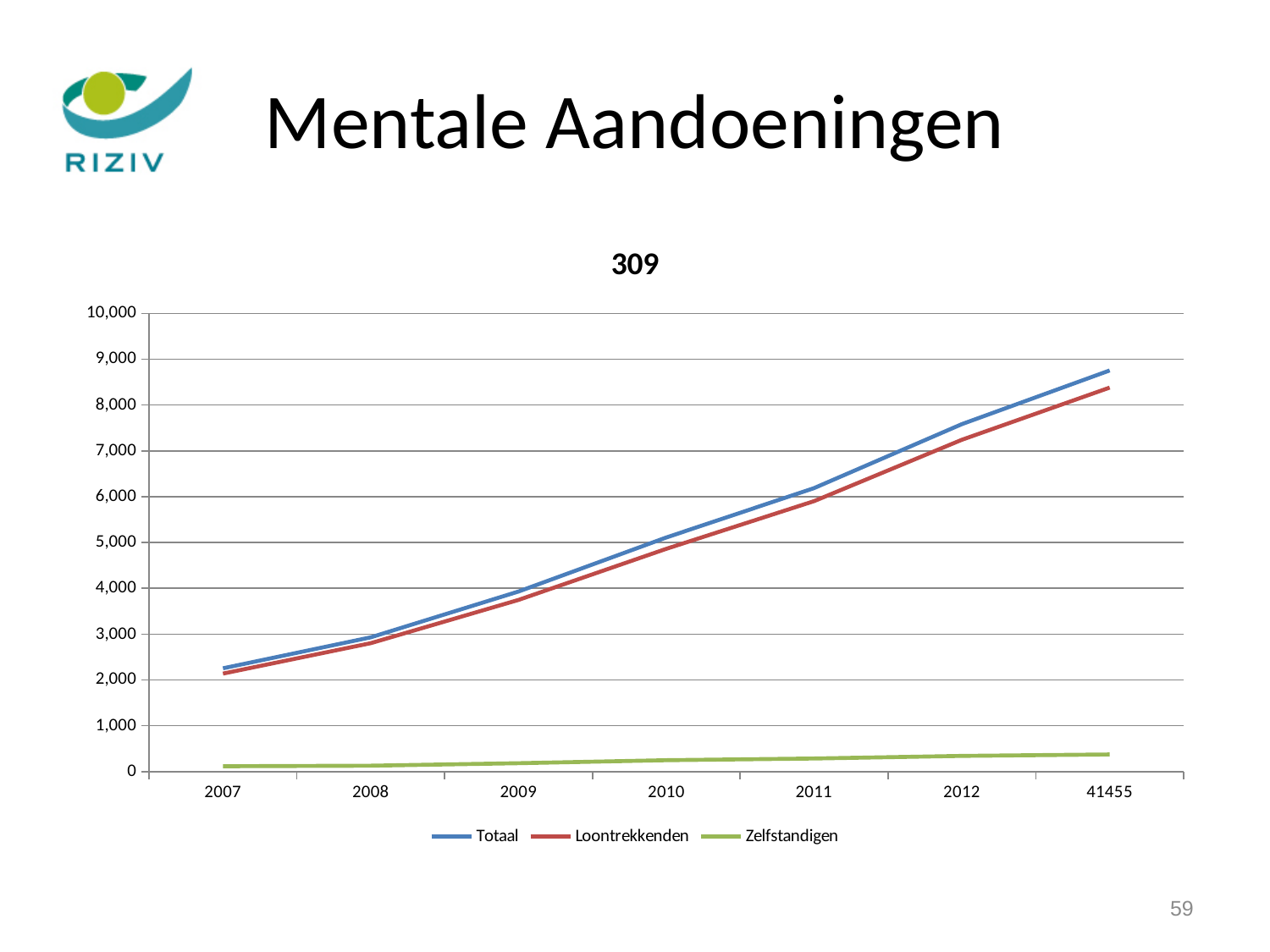
Which series has the highest values across all years? Totaal Is the value for Totaal in 2007 greater or less than 2,000? greater Which series has the lowest values across all years? Zelfstandigen Is the value for Zelfstandigen in 2012 greater or less than 1,000? less How many points are plotted along the x axis for each series? 7 Is the value for Totaal at 41455 greater or less than 8,000? greater What is the title of the chart? 309 Which series are listed in the legend? Totaal, Loontrekkenden, Zelfstandigen Which is larger in 2010, the value for Loontrekkenden or the value for Zelfstandigen? Loontrekkenden How many series does the legend list? 3 What kind of chart is shown on the slide? Line chart Does the Totaal series rise or fall from 2007 to 41455? Rise